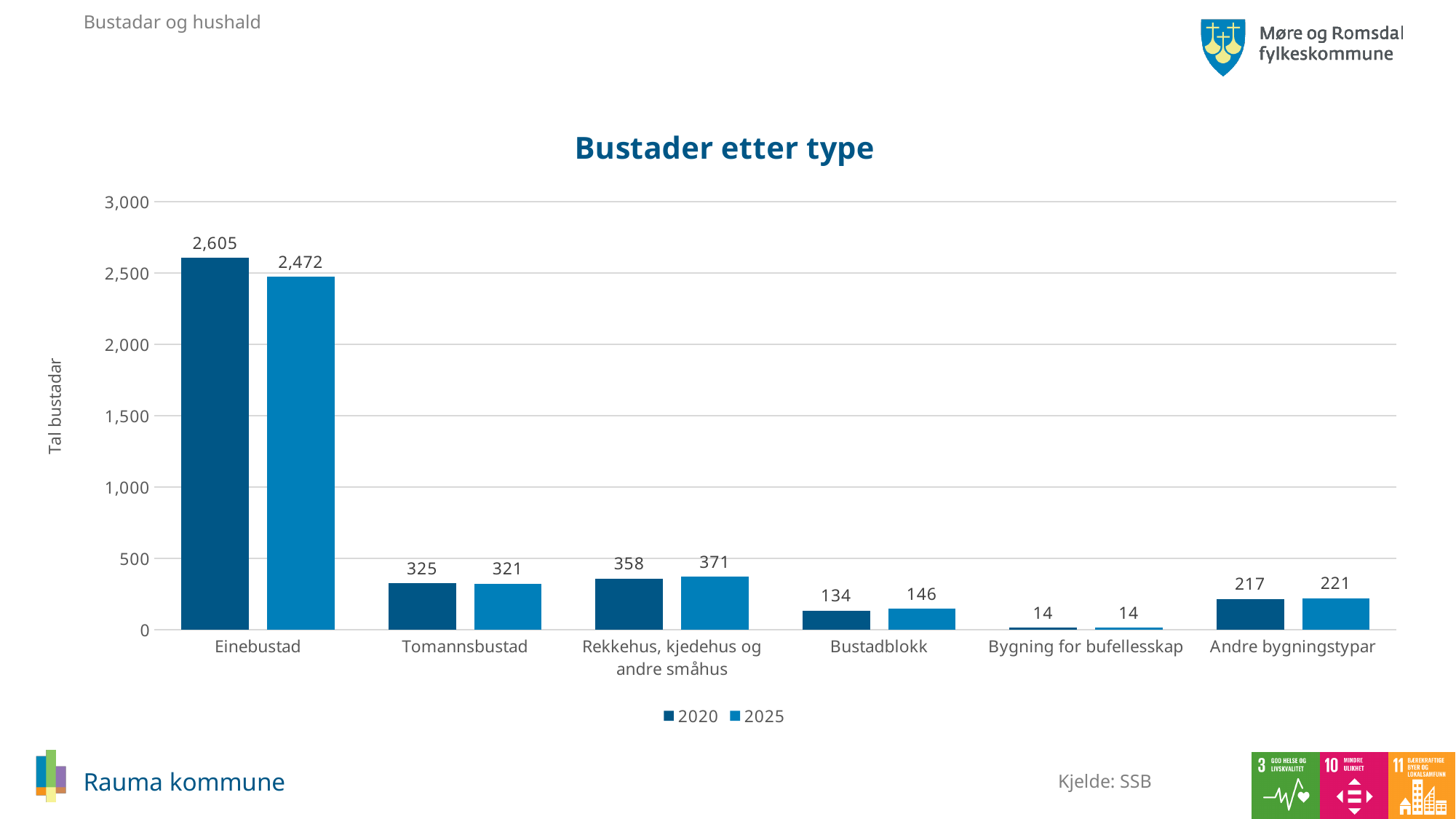
What is the difference between the 2020 and 2025 values for Einebustad? 133 Which is larger for Rekkehus, kjedehus og andre småhus: the 2020 value or the 2025 value? 2025 What is the value for Einebustad in 2020? 2,605 How many series does the legend list? 2 How many categories are shown on the x axis? 6 What kind of chart is shown? bar chart What is the value for Andre bygningstypar in 2020? 217 What is the value for Bustadblokk in 2025? 146 Is the 2025 value for Tomannsbustad greater or less than 500? less What is the title of the chart? Bustader etter type Which category has the lowest value in 2020? Bygning for bufellesskap Which category has the highest value in 2025? Einebustad